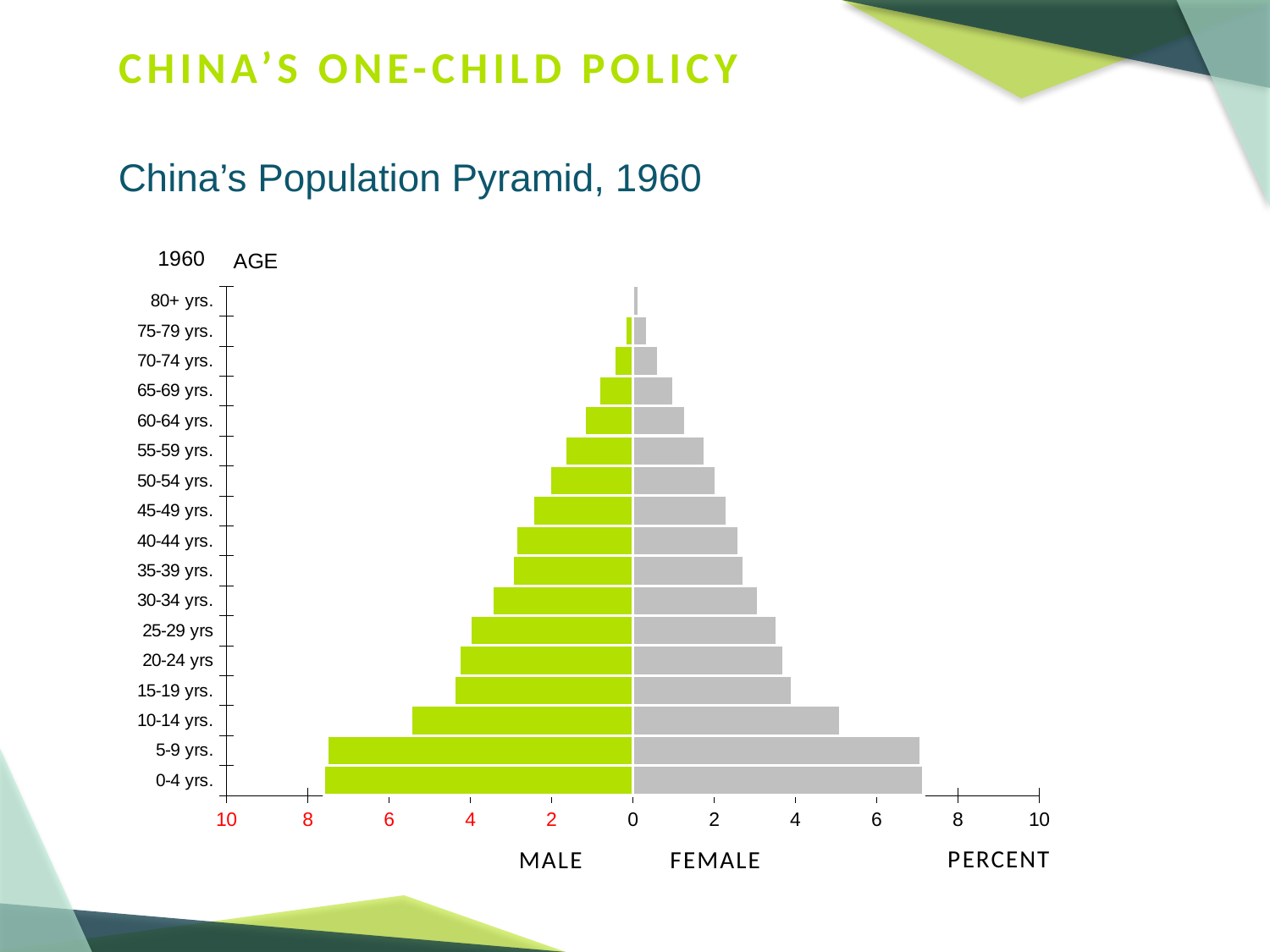
Is the female value for the 30-34 yrs. age group greater or less than 4? less Which is larger, the male value for 10-14 yrs. or the male value for 15-19 yrs.? 10-14 yrs. What is the title of the chart? China's Population Pyramid, 1960 Which age group has the smallest female share of the population? 80+ yrs. Do the bar lengths generally increase or decrease as age increases from 0-4 yrs. to 80+ yrs.? decrease Which age group has the smallest male share of the population? 80+ yrs. Is the male value for the 0-4 yrs. age group greater or less than 6? greater Is the female value for the 10-14 yrs. age group greater or less than 4? greater How many age groups are shown on the chart? 17 What kind of chart is shown on the slide? bar chart Which colour represents the female population on the chart? grey